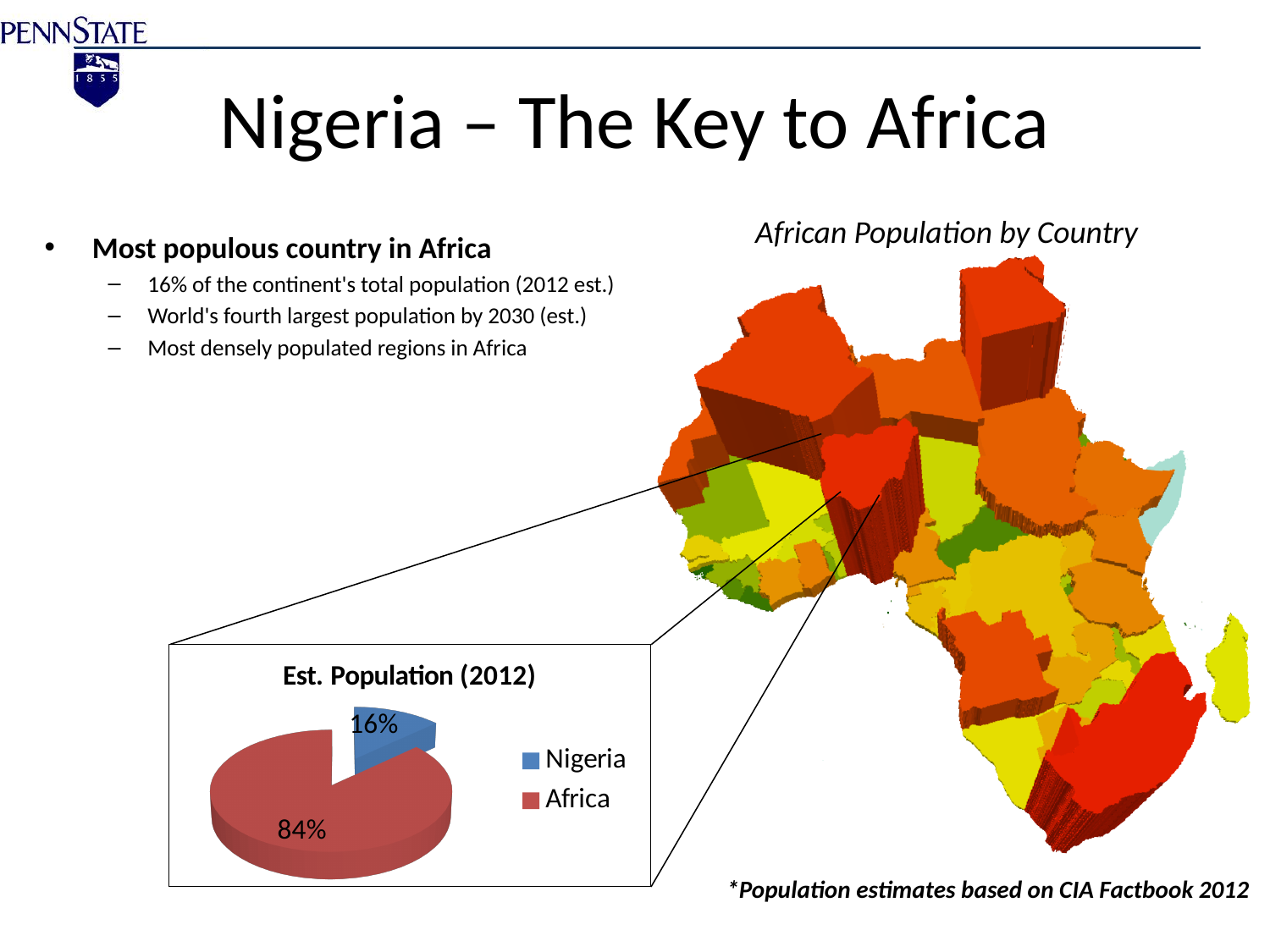
What is the difference in percentage points between the Africa and Nigeria slices in the "Est. Population (2012)" pie chart? 68 How many slices does the "Est. Population (2012)" pie chart have? 2 Which slice is larger in the "Est. Population (2012)" pie chart, Nigeria or Africa? Africa How many entries does the legend of the "Est. Population (2012)" pie chart list? 2 Which category has the largest slice in the "Est. Population (2012)" pie chart? Africa In the "Est. Population (2012)" pie chart, what share does Africa have? 84% What kind of chart is the "Est. Population (2012)" chart? pie chart What is the title of the pie chart on the slide? Est. Population (2012) What colour is the Nigeria slice in the "Est. Population (2012)" pie chart? blue In the "Est. Population (2012)" pie chart, what share does Nigeria have? 16% Which category has the smallest slice in the "Est. Population (2012)" pie chart? Nigeria